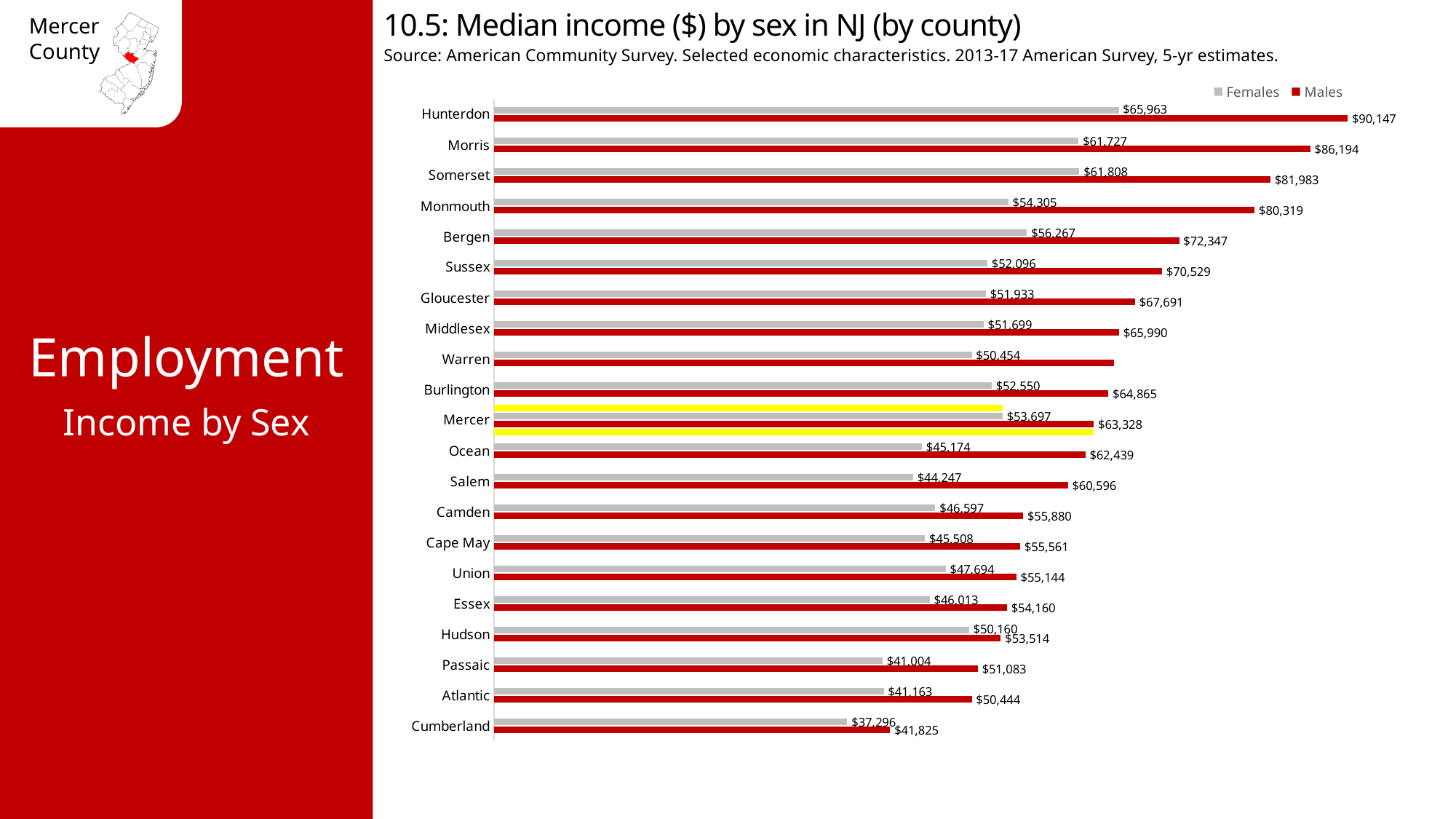
What is the median income for Females in Mercer county? $53,697 What is the median income for Males in Hunterdon county? $90,147 What is the median income for Males in Cumberland county? $41,825 Which colour represents the Males series in the chart? Red What type of chart is shown on the slide? Bar chart What is the difference between the Males and Females median income in Mercer county? $9,631 How many counties are shown in the chart? 21 What is the difference between the Males and Females median income in Hunterdon county? $24,184 How many series does the legend list? 2 Which county has the highest median income for Females? Hunterdon Which county has the lowest median income for Males? Cumberland Which is larger, the Females median income in Bergen or in Monmouth? Bergen